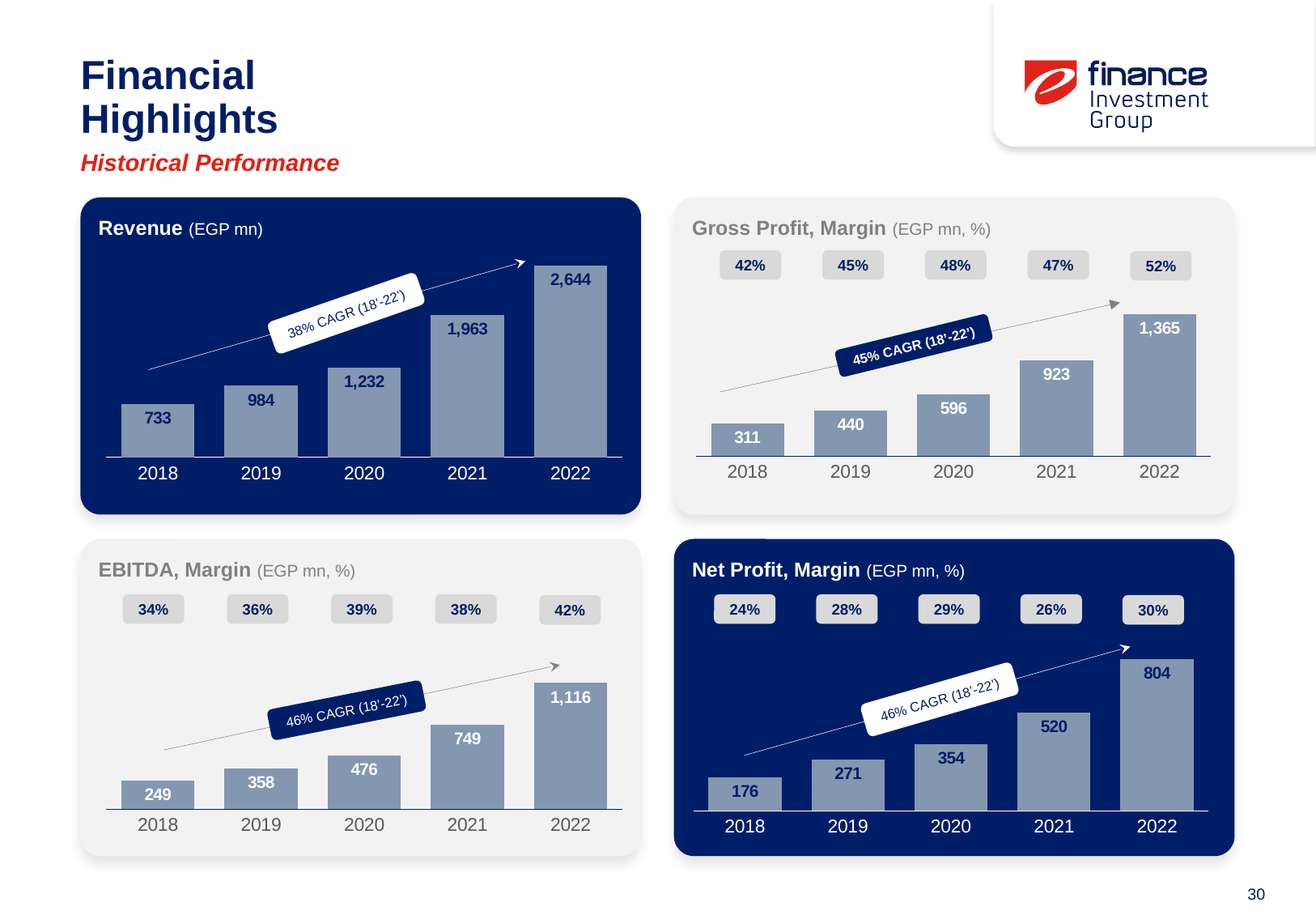
In the Gross Profit, Margin chart, which is larger, the gross profit for 2019 or for 2020? 2020 How many years are shown on the x axis of the Revenue chart? 5 In the EBITDA, Margin chart, what is the EBITDA margin shown for 2021? 38% In the Revenue chart, which year has the lowest revenue? 2018 In the Revenue chart, what is the value for 2022? 2,644 In the Net Profit, Margin chart, what is the net profit value for 2019? 271 In the Gross Profit, Margin chart, what is the gross profit value for 2020? 596 In the Net Profit, Margin chart, which year has the highest net profit? 2022 In the Revenue chart, what is the difference between the 2022 and 2021 revenue values? 681 What kind of chart is the Net Profit, Margin chart? Bar chart In the Gross Profit, Margin chart, do the gross profit values rise or fall from 2018 to 2022? Rise In the EBITDA, Margin chart, what is the difference between the 2022 and 2018 EBITDA values? 867